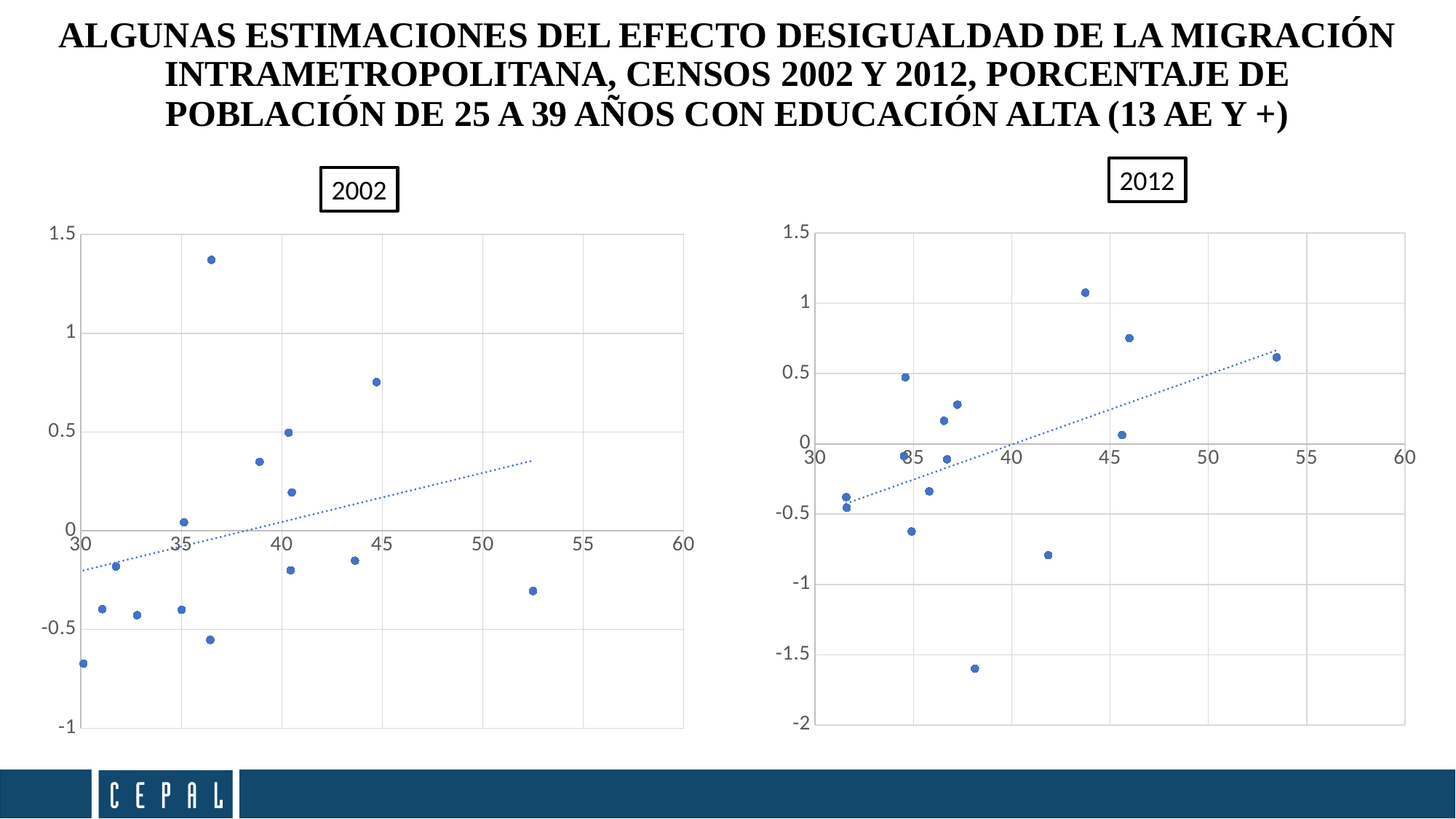
In the 2002 chart, is the highest point greater or less than 1 on the vertical axis? greater What kind of chart is the 2002 chart? scatter chart In the 2002 chart, does the dotted trend line rise or fall as the x-axis value increases? rises What range does the horizontal axis cover in both charts? 30 to 60 Which chart has the lower minimum point on the vertical axis, 2002 or 2012? 2012 In the 2012 chart, does the dotted trend line rise or fall as the x-axis value increases? rises In the 2002 chart, is the rightmost point greater or less than 50 on the horizontal axis? greater What is the lowest value shown on the vertical axis of the 2012 chart? -2 In the 2012 chart, is the lowest point greater or less than -1.5 on the vertical axis? less Which chart has the higher maximum point on the vertical axis, 2002 or 2012? 2002 What kind of chart is the 2012 chart? scatter chart